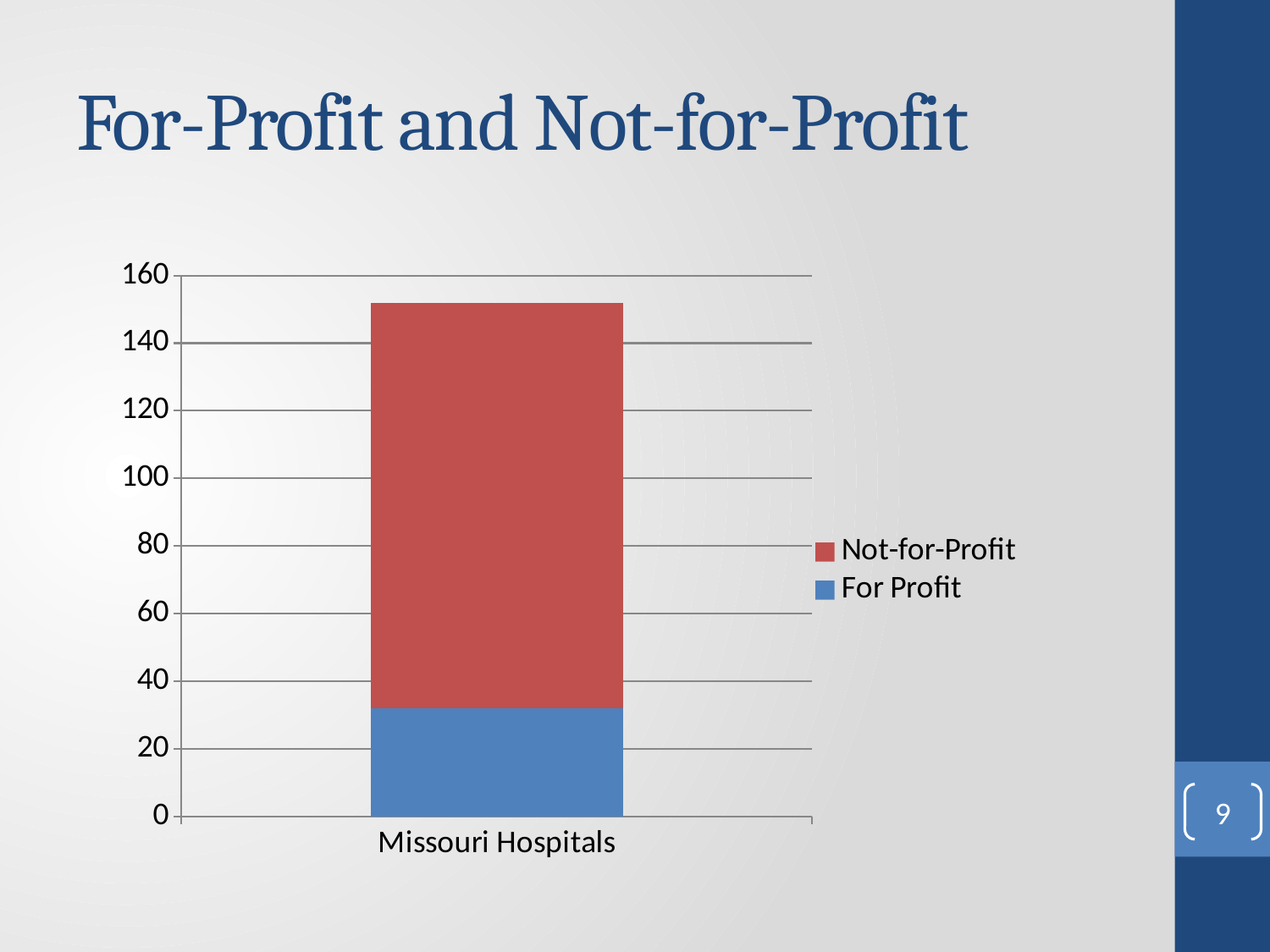
Is the total height of the Missouri Hospitals bar greater or less than 160? less What is the label of the category on the x axis? Missouri Hospitals Is the total height of the Missouri Hospitals bar greater or less than 140? greater Is the For Profit value for Missouri Hospitals greater or less than 20? greater How many series does the legend list? 2 How many categories are plotted on the x axis? 1 Which series is larger for Missouri Hospitals, Not-for-Profit or For Profit? Not-for-Profit Which colour represents the For Profit series? blue What kind of chart is shown on the slide? stacked bar chart